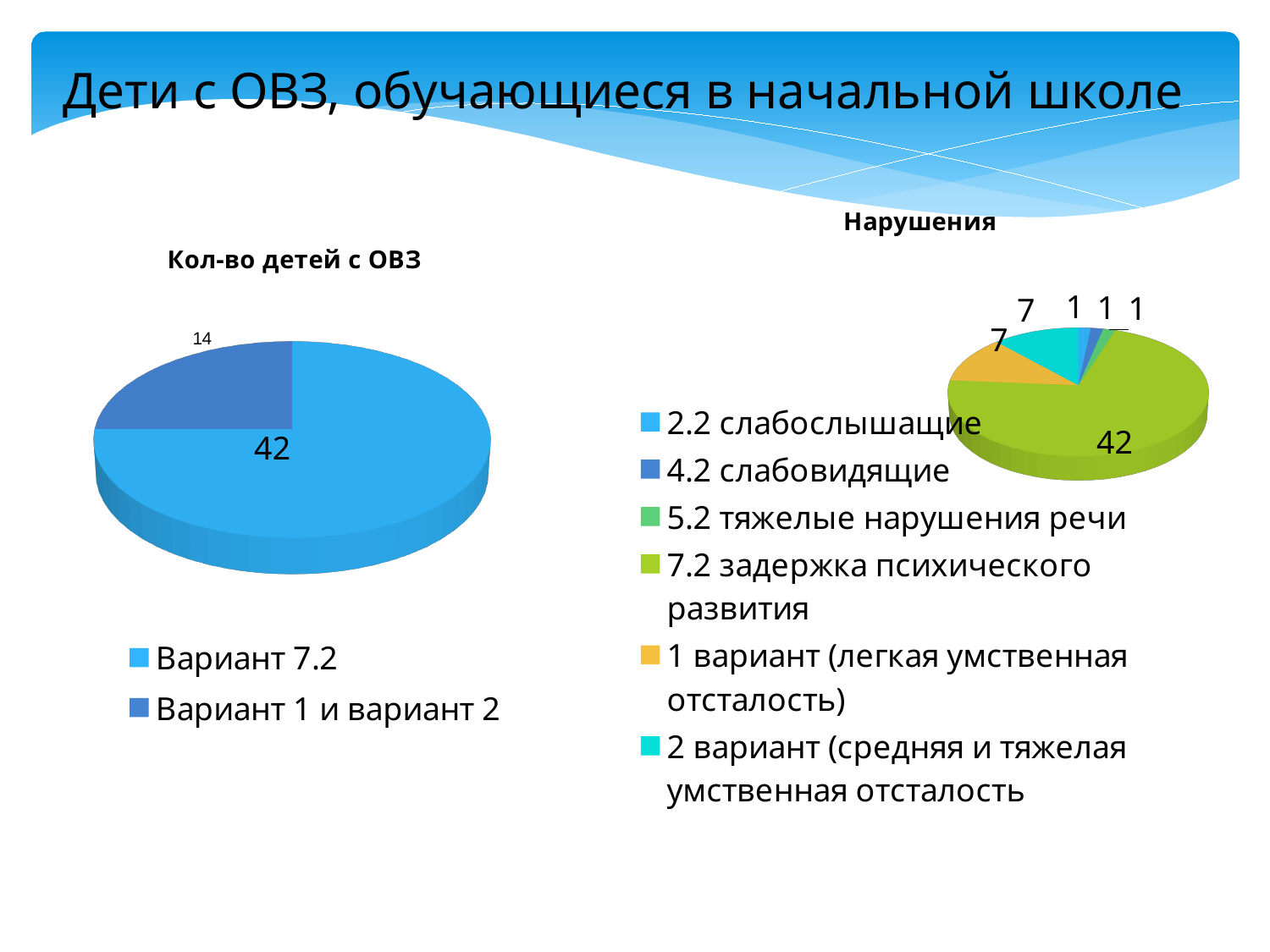
In the chart titled "Нарушения", what is the value for "1 вариант (легкая умственная отсталость)"? 7 In the chart titled "Кол-во детей с ОВЗ", what is the difference between the values for "Вариант 7.2" and "Вариант 1 и вариант 2"? 28 In the chart titled "Кол-во детей с ОВЗ", how many categories does the legend list? 2 In the chart titled "Нарушения", what is the value for "2.2 слабослышащие"? 1 In the chart titled "Нарушения", what is the value for "7.2 задержка психического развития"? 42 In the chart titled "Нарушения", which category has the largest slice? 7.2 задержка психического развития In the chart titled "Кол-во детей с ОВЗ", what share of the pie does "Вариант 7.2" represent? 75% In the chart titled "Кол-во детей с ОВЗ", what is the value for "Вариант 7.2"? 42 In the chart titled "Нарушения", how many categories does the legend list? 6 In the chart titled "Нарушения", which is larger: the value for "7.2 задержка психического развития" or the value for "1 вариант (легкая умственная отсталость)"? 7.2 задержка психического развития In the chart titled "Кол-во детей с ОВЗ", what is the value for "Вариант 1 и вариант 2"? 14 What kind of chart is the chart titled "Нарушения"? Pie chart